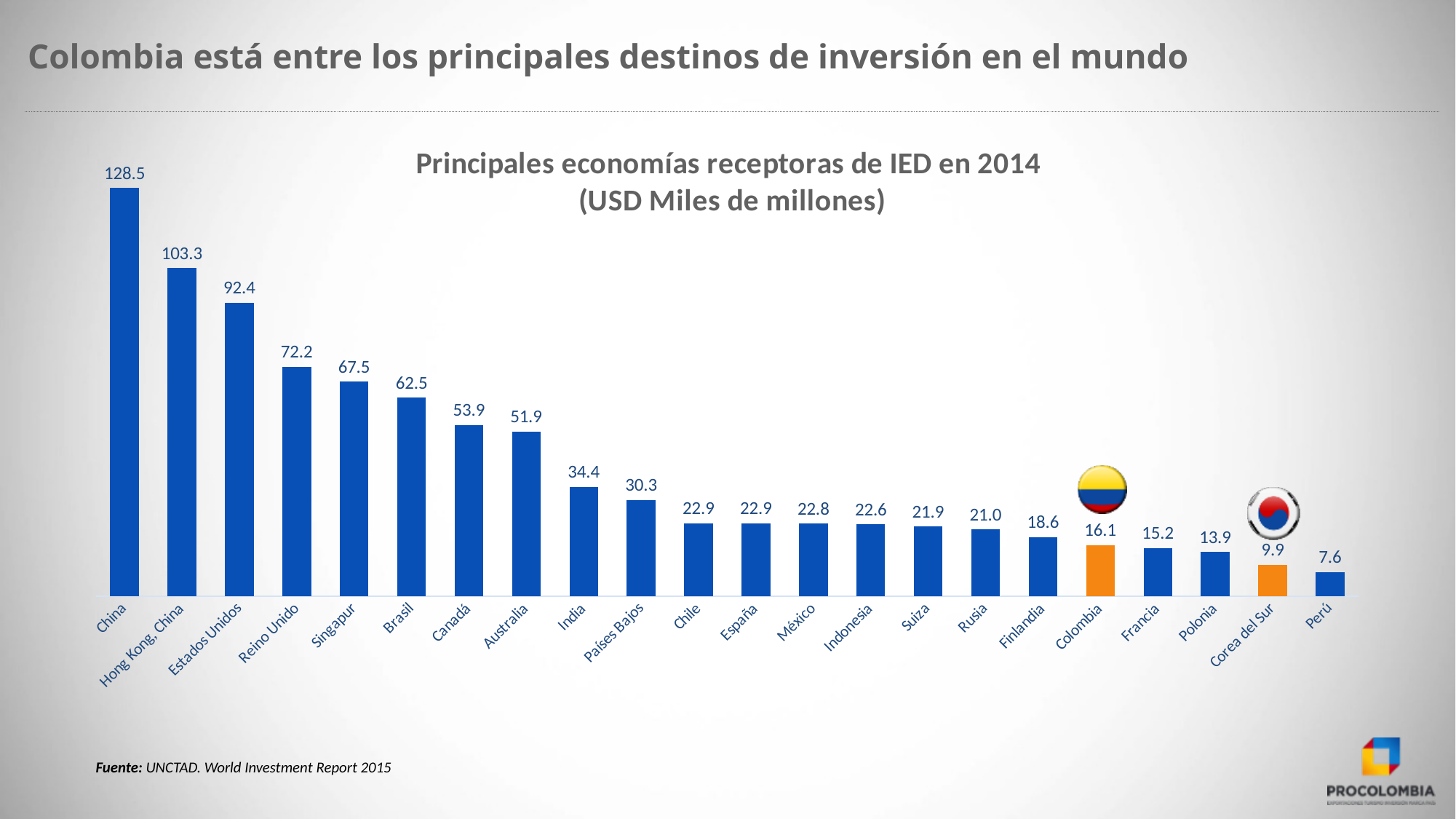
Which country has the lowest value? Perú What is the value for Estados Unidos? 92.4 Do the values rise or fall from left to right along the x axis? Fall What is the title of the chart? Principales economías receptoras de IED en 2014 (USD Miles de millones) Which country has the highest value? China What is the difference between the values for China and Hong Kong, China? 25.2 What is the value for Colombia? 16.1 Which is larger, the value for Brasil or the value for Canadá? Brasil What kind of chart is shown on the slide? Bar chart How many countries are shown in the chart? 22 What is the difference between the values for Colombia and Corea del Sur? 6.2 What is the value for Corea del Sur? 9.9